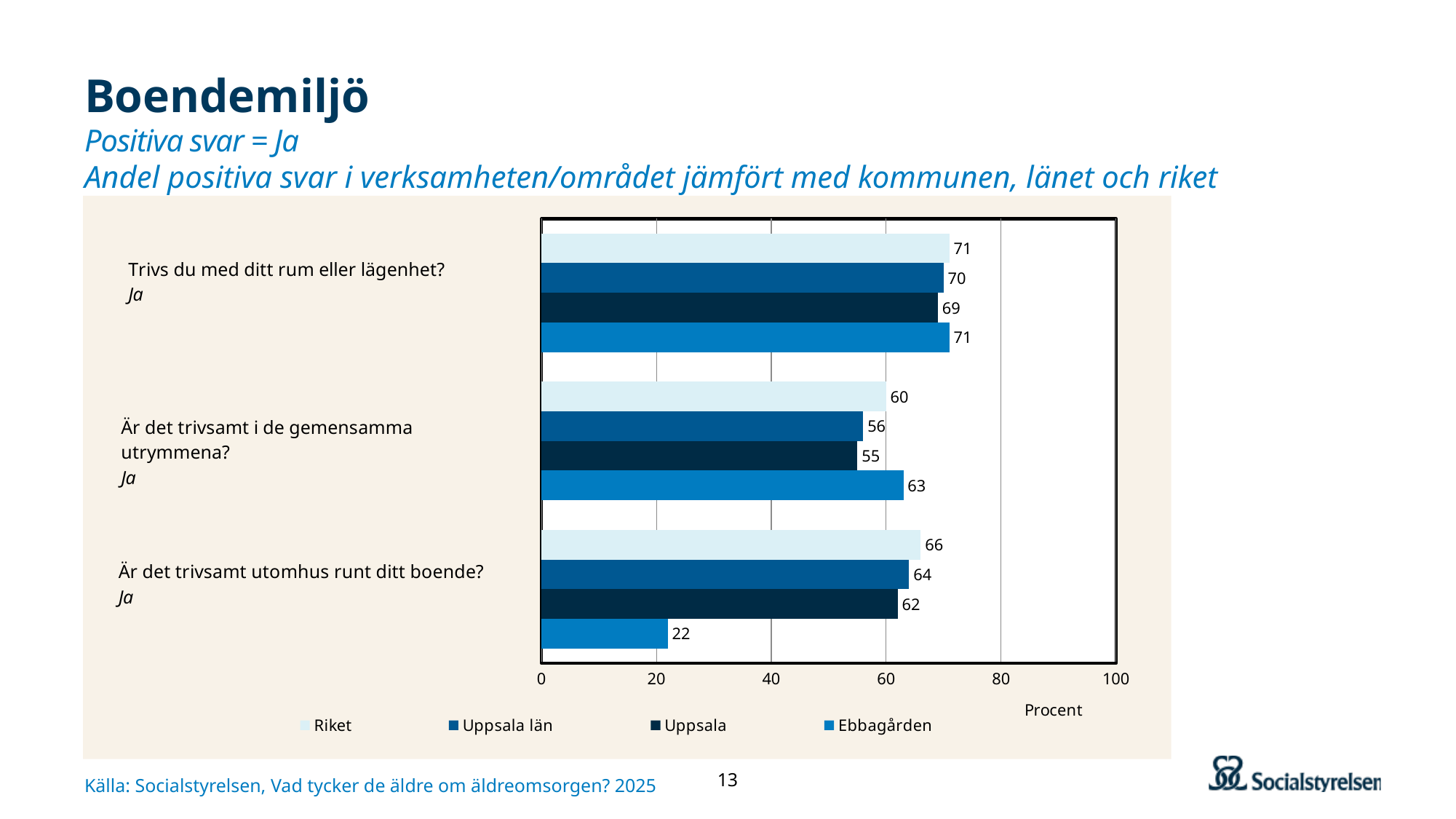
What is the value for Ebbagården on "Är det trivsamt utomhus runt ditt boende?"? 22 What is the value for Uppsala län on "Är det trivsamt utomhus runt ditt boende?"? 64 What is the difference between Riket and Ebbagården on "Är det trivsamt utomhus runt ditt boende?"? 44 What is the value for Uppsala on "Trivs du med ditt rum eller lägenhet?"? 69 What kind of chart is shown on the slide? Bar chart What unit is shown on the x axis of the chart? Procent How many questions (categories) are shown on the chart? 3 Which series has the lowest value on "Är det trivsamt utomhus runt ditt boende?"? Ebbagården How many series does the legend list? 4 Which series has the highest value on "Är det trivsamt i de gemensamma utrymmena?"? Ebbagården Which is larger on "Är det trivsamt i de gemensamma utrymmena?": Riket or Uppsala? Riket What is the value for Riket on "Är det trivsamt i de gemensamma utrymmena?"? 60